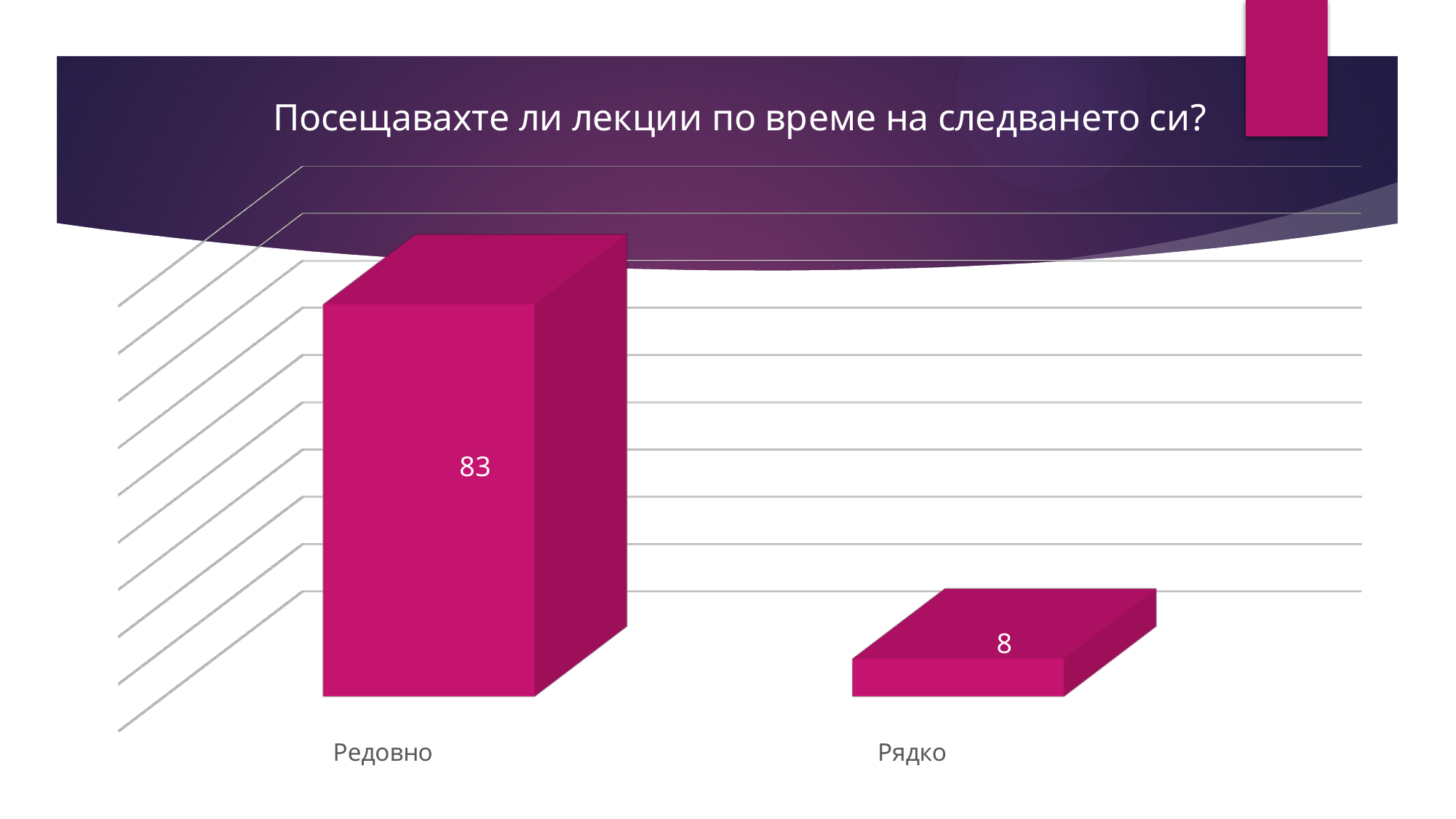
What colour are the bars in the chart? magenta Which is larger, the value for Редовно or the value for Рядко? Редовно What kind of chart is shown on the slide? bar chart What is the total of the two values shown in the chart? 91 Which category has the highest value? Редовно How many categories are shown in the chart? 2 What is the title of the slide? Посещавахте ли лекции по време на следването си? What is the value for Редовно? 83 What is the value for Рядко? 8 What is the difference between the values for Редовно and Рядко? 75 Which category has the lowest value? Рядко